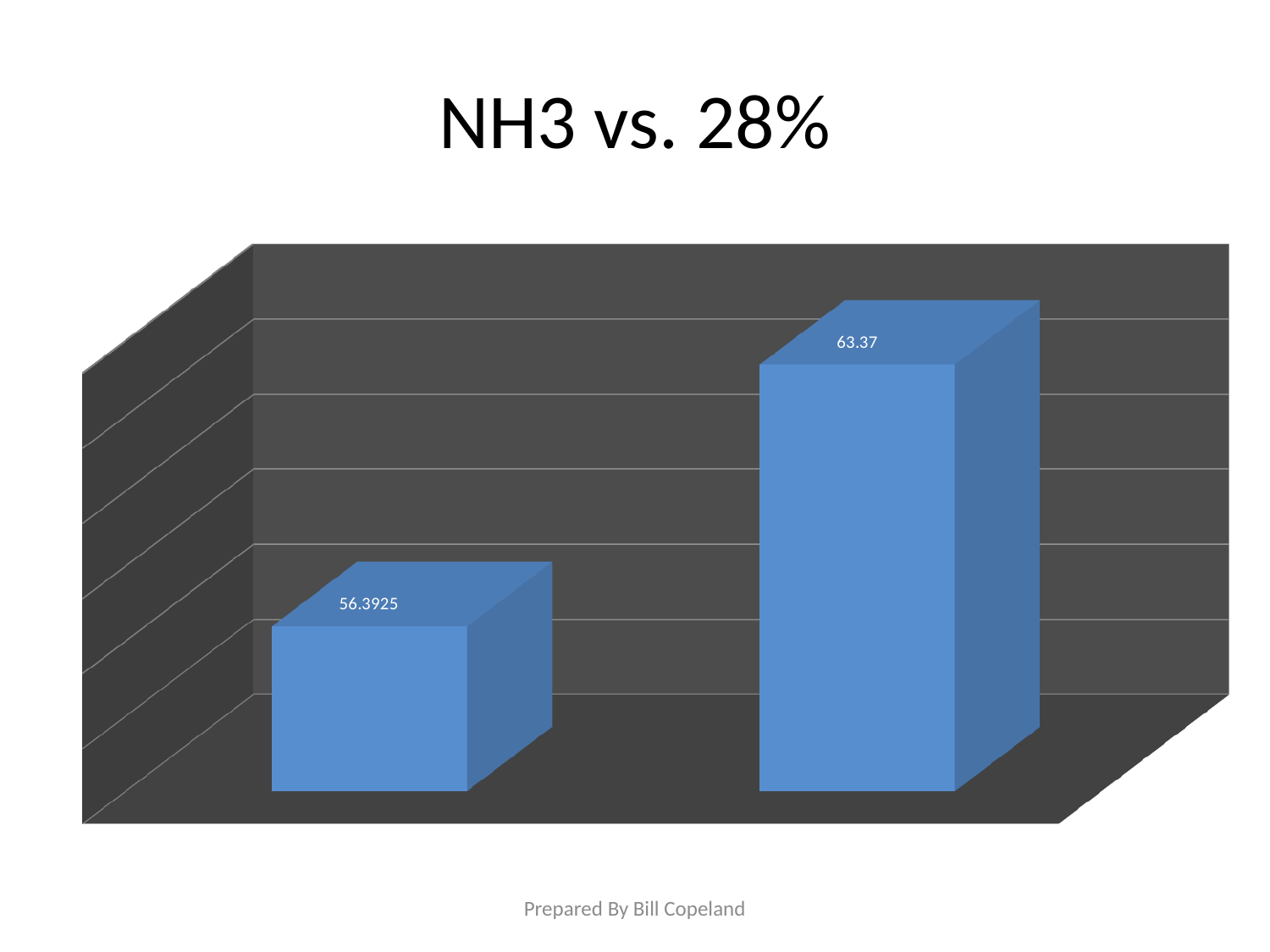
What is the value shown on the left bar? 56.3925 What is the difference between the right bar's value and the left bar's value? 6.9775 Do the values rise or fall from the left bar to the right bar? rise Which bar has the lowest value? the left bar What colour are the bars in the chart? blue What kind of chart is shown on the slide? bar chart What is the title of the slide containing the chart? NH3 vs. 28% What is the value shown on the right bar? 63.37 Which bar is taller, the left bar or the right bar? the right bar How many bars are plotted in the chart? 2 Is the value of the left bar larger or smaller than the value of the right bar? smaller